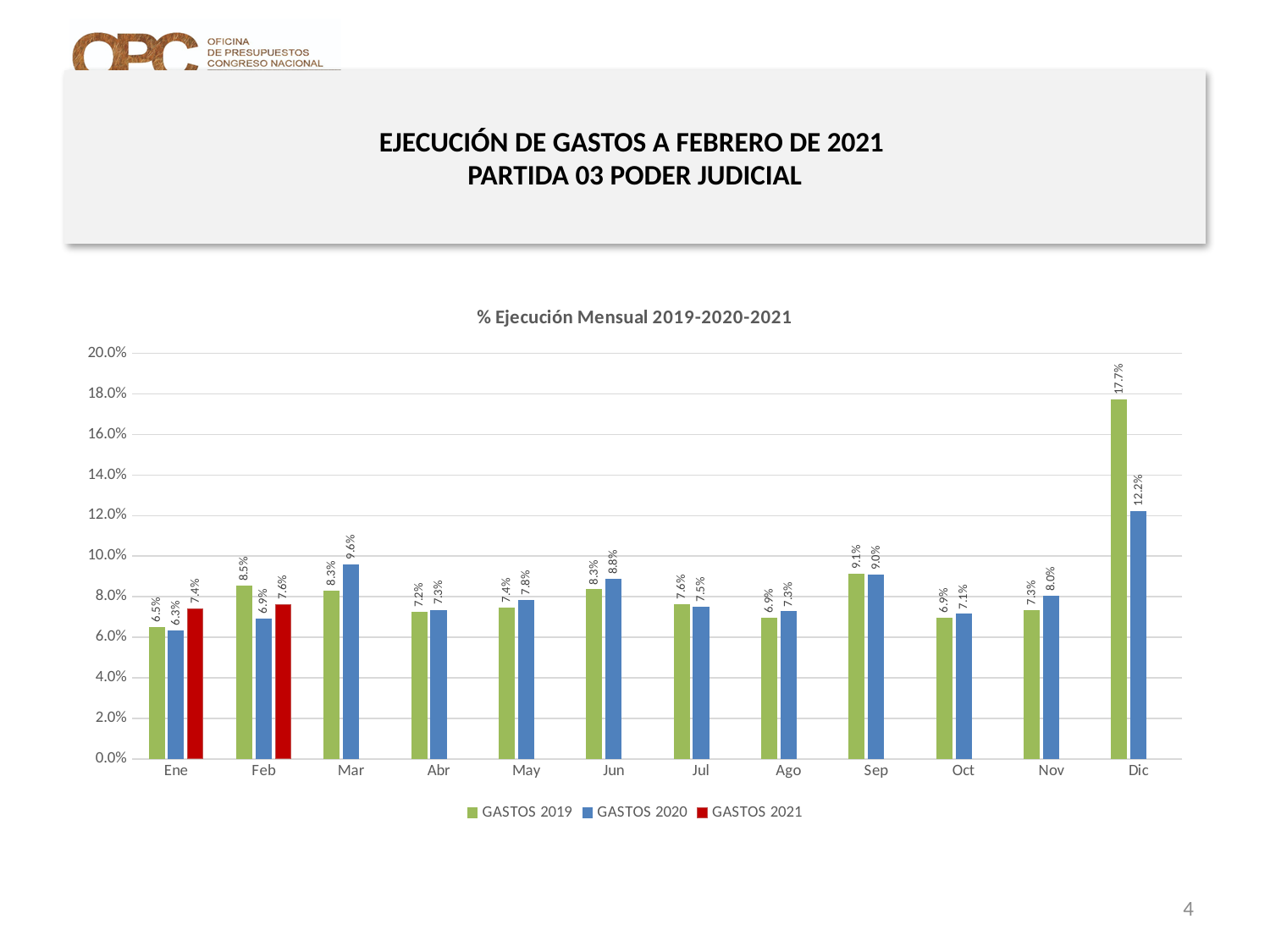
How many series does the legend list? 3 What is the value for GASTOS 2019 in Dic? 17.7% What is the title of the chart? % Ejecución Mensual 2019-2020-2021 Which month has the lowest value for GASTOS 2019? Ene What is the value for GASTOS 2021 in Feb? 7.6% What is the value for GASTOS 2020 in Mar? 9.6% What is the difference between GASTOS 2019 and GASTOS 2020 in Dic? 5.5% Which month has the highest value for GASTOS 2020? Dic What kind of chart is shown on the slide? bar chart Which is larger in Feb, GASTOS 2019 or GASTOS 2020? GASTOS 2019 Is the value for GASTOS 2020 in Dic greater or less than 10.0%? greater How many months are shown on the x axis? 12